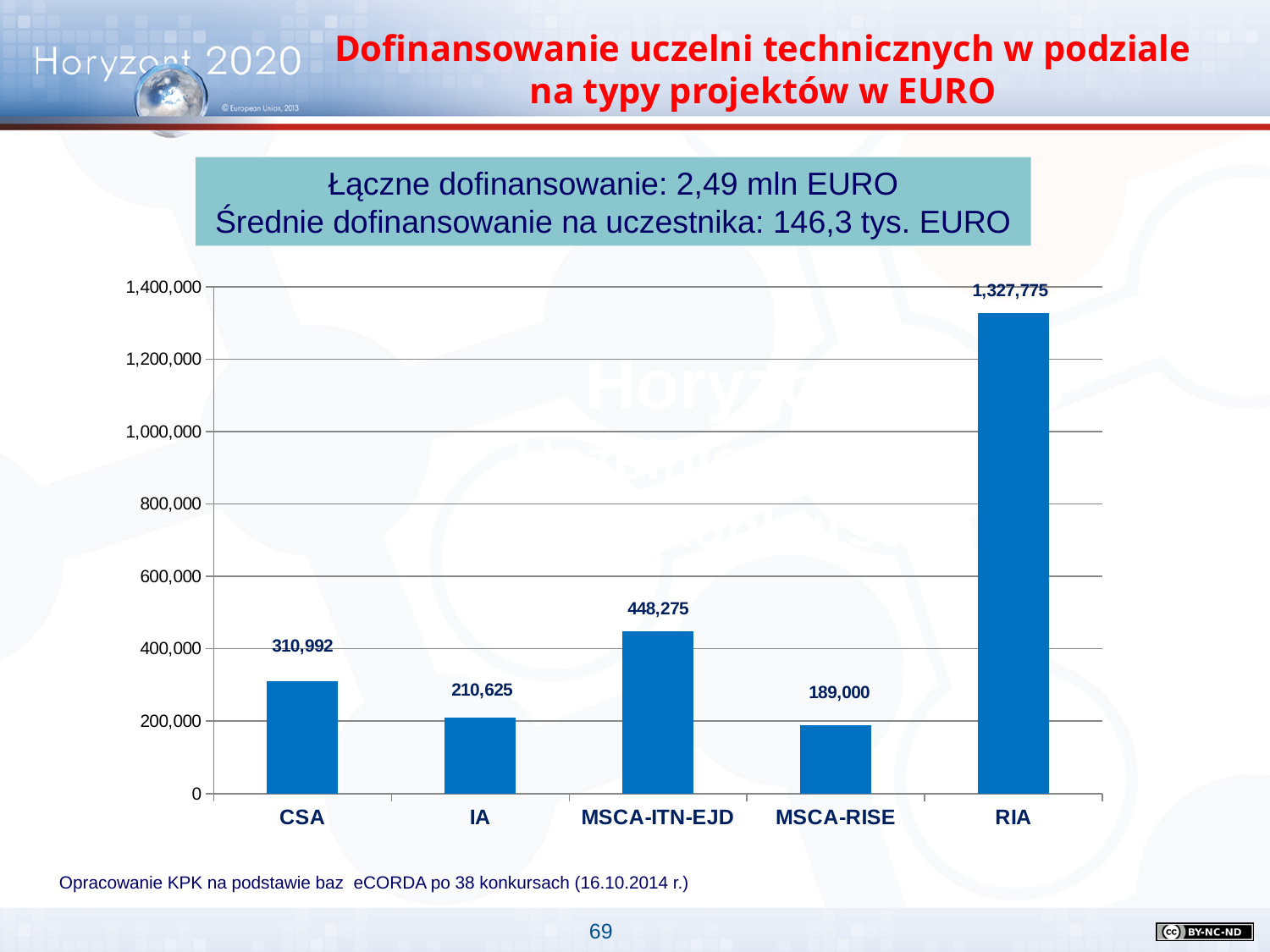
What is the difference between the values for MSCA-ITN-EJD and IA? 237,650 What is the difference between the values for RIA and CSA? 1,016,783 Which category has the lowest value? MSCA-RISE Which is larger, the value for CSA or the value for IA? CSA What is the value for MSCA-RISE? 189,000 Which category has the highest value? RIA What is the value for IA? 210,625 What kind of chart is shown on the slide? bar chart How many categories are shown on the x axis? 5 What is the value for MSCA-ITN-EJD? 448,275 Is the value for RIA greater or less than 1,200,000? greater What is the value for RIA? 1,327,775